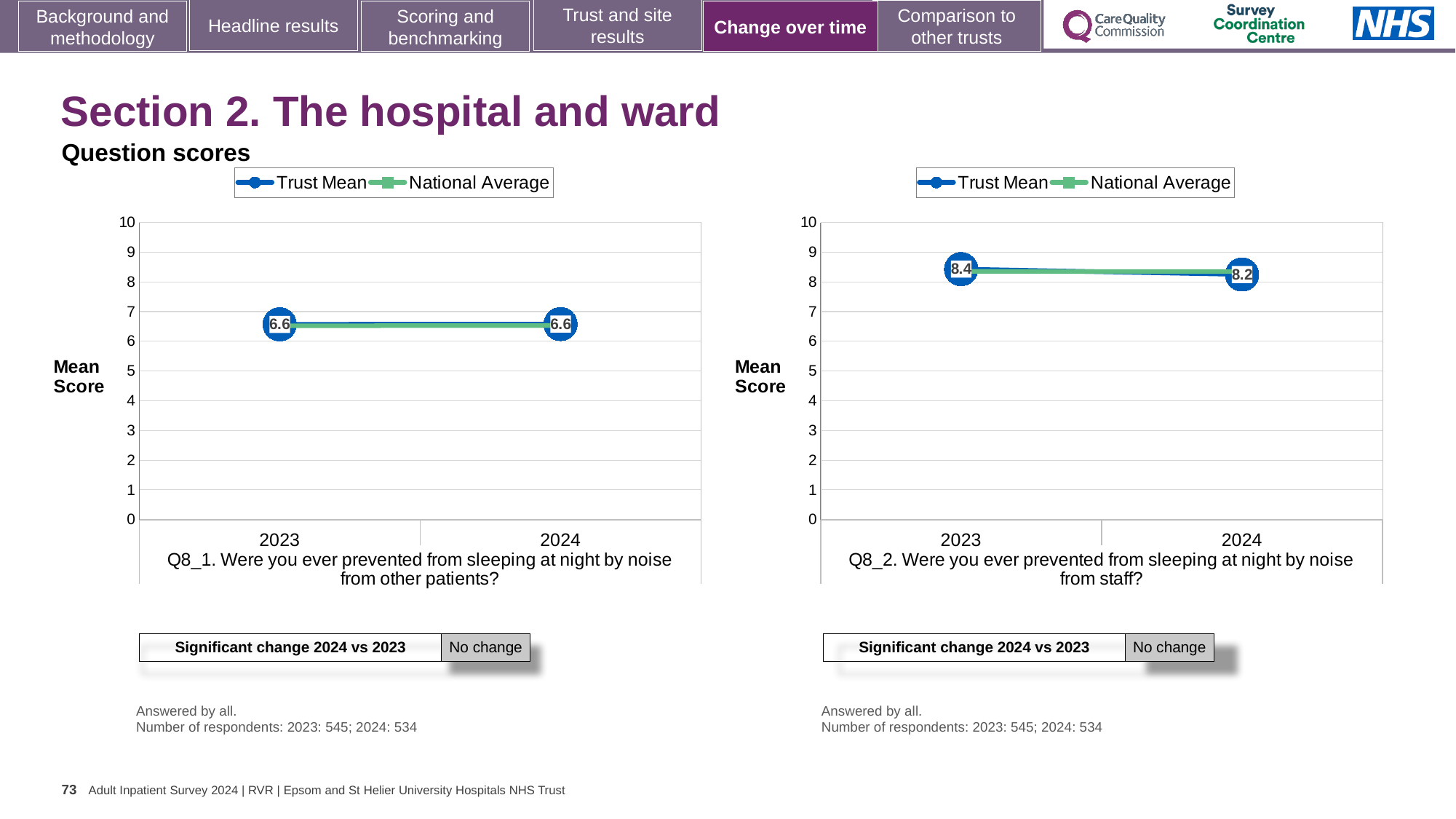
In the left chart (Q8_1), what is the Trust Mean score for 2023? 6.6 How many series does the legend of the left chart (Q8_1) list? 2 In the left chart (Q8_1), is the Trust Mean for 2024 greater or less than 7? less In the right chart (Q8_2), does the Trust Mean rise or fall from 2023 to 2024? fall In the right chart (Q8_2), what is the Trust Mean score for 2023? 8.4 In the left chart (Q8_1), what is the Trust Mean score for 2024? 6.6 In the right chart (Q8_2), what is the Trust Mean score for 2024? 8.2 How many years are plotted on the x axis of the right chart (Q8_2)? 2 In the right chart (Q8_2), what is the difference between the Trust Mean scores for 2023 and 2024? 0.2 What type of chart is the left chart (Q8_1)? line chart Which chart has the higher Trust Mean score for 2024, the left chart (Q8_1) or the right chart (Q8_2)? the right chart (Q8_2) In the right chart (Q8_2), is the Trust Mean for 2023 greater or less than 8? greater